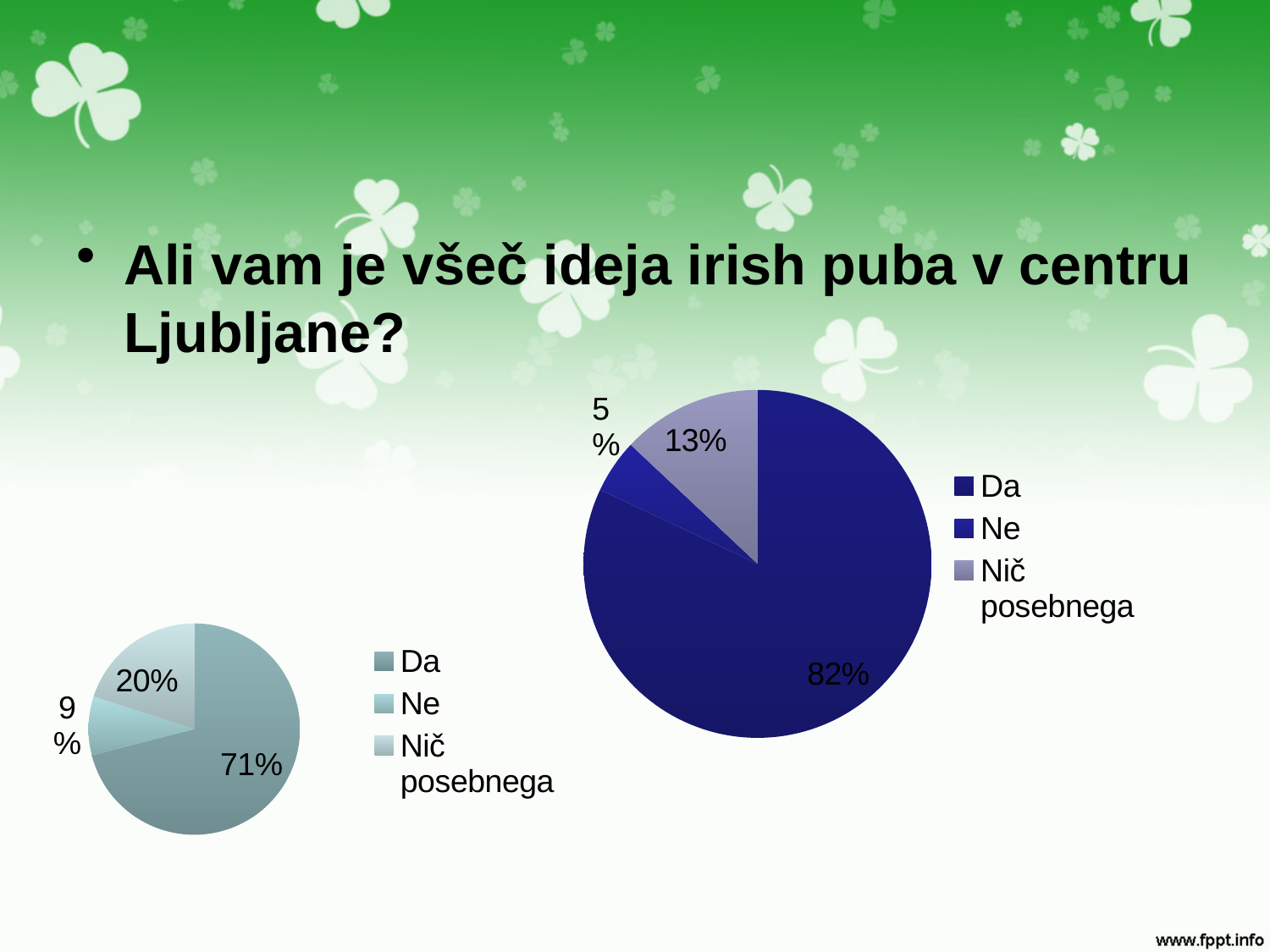
In the pie chart on the bottom left of the slide, which is larger, the Ne slice or the Nič posebnega slice? Nič posebnega In the pie chart on the right of the slide, what share is labelled for Da? 82% In the pie chart on the right of the slide, what is the difference between the Da share and the Nič posebnega share? 69% What type of chart is shown on the bottom left of the slide? Pie chart In the pie chart on the right of the slide, what share is labelled for Ne? 5% In the pie chart on the bottom left of the slide, what share is labelled for Da? 71% In the pie chart on the bottom left of the slide, what share is labelled for Ne? 9% In the pie chart on the right of the slide, what share is labelled for Nič posebnega? 13% In the pie chart on the right of the slide, which category has the largest slice? Da In the pie chart on the bottom left of the slide, what share is labelled for Nič posebnega? 20% How many categories does the legend of the pie chart on the right of the slide list? 3 In the pie chart on the bottom left of the slide, which category has the smallest slice? Ne